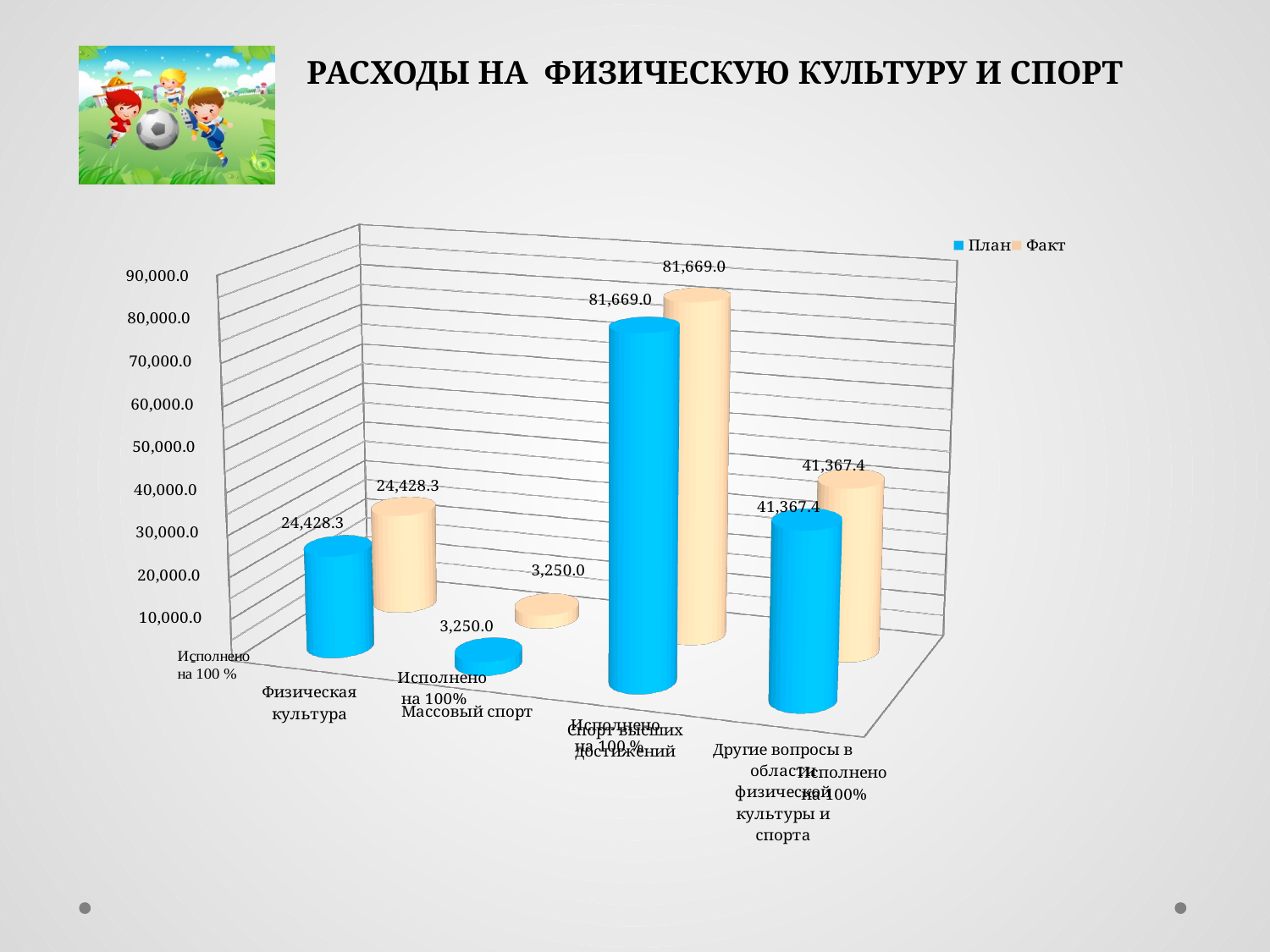
How many series does the legend list? 2 What is the title of the slide? РАСХОДЫ НА ФИЗИЧЕСКУЮ КУЛЬТУРУ И СПОРТ How many categories are shown on the x axis? 4 What is the difference between the План values for Спорт высших достижений and Физическая культура? 57,240.7 Which category has the highest План value? Спорт высших достижений What is the План value for Физическая культура? 24,428.3 What kind of chart is shown on the slide? Bar chart Which is larger: the Факт value for Физическая культура or the Факт value for Другие вопросы в области физической культуры и спорта? Другие вопросы в области физической культуры и спорта What is the Факт value for Массовый спорт? 3,250.0 Which category has the lowest Факт value? Массовый спорт What is the Факт value for Другие вопросы в области физической культуры и спорта? 41,367.4 What is the План value for Спорт высших достижений? 81,669.0